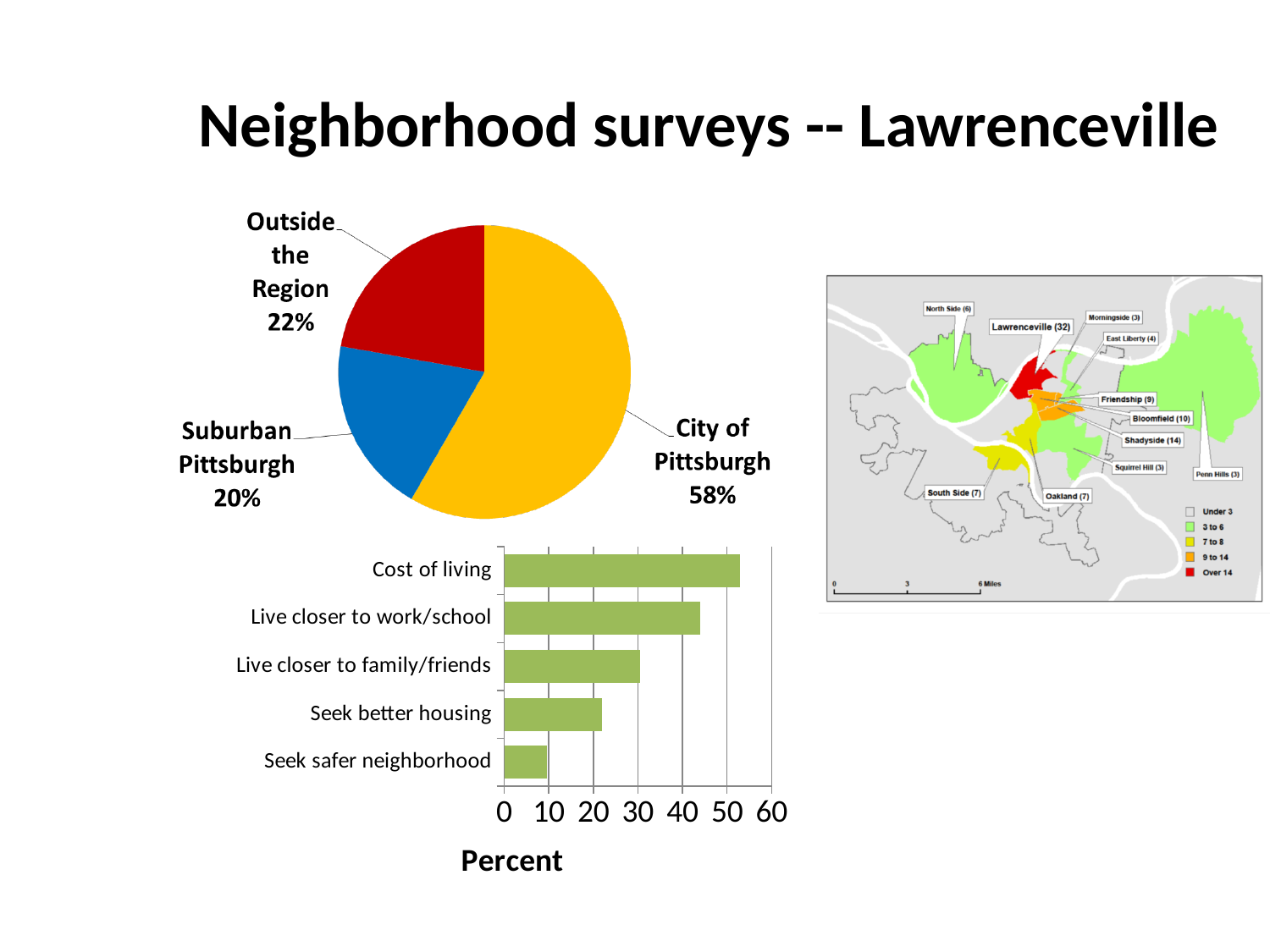
In the bar chart, which reason has the highest percent? Cost of living In the pie chart, what share of respondents came from Suburban Pittsburgh? 20% In the pie chart, which category has the largest share? City of Pittsburgh What type of chart is the lower-left chart showing reasons such as Cost of living? Bar chart How many slices does the pie chart have? 3 In the bar chart, is the value for Cost of living greater or less than 50? greater In the pie chart, which category has the smallest share? Suburban Pittsburgh In the bar chart, which reason has the lowest percent? Seek safer neighborhood In the pie chart, what share of respondents came from Outside the Region? 22% In the pie chart, what share of respondents came from the City of Pittsburgh? 58% In the pie chart, what is the difference in percentage points between City of Pittsburgh and Outside the Region? 36